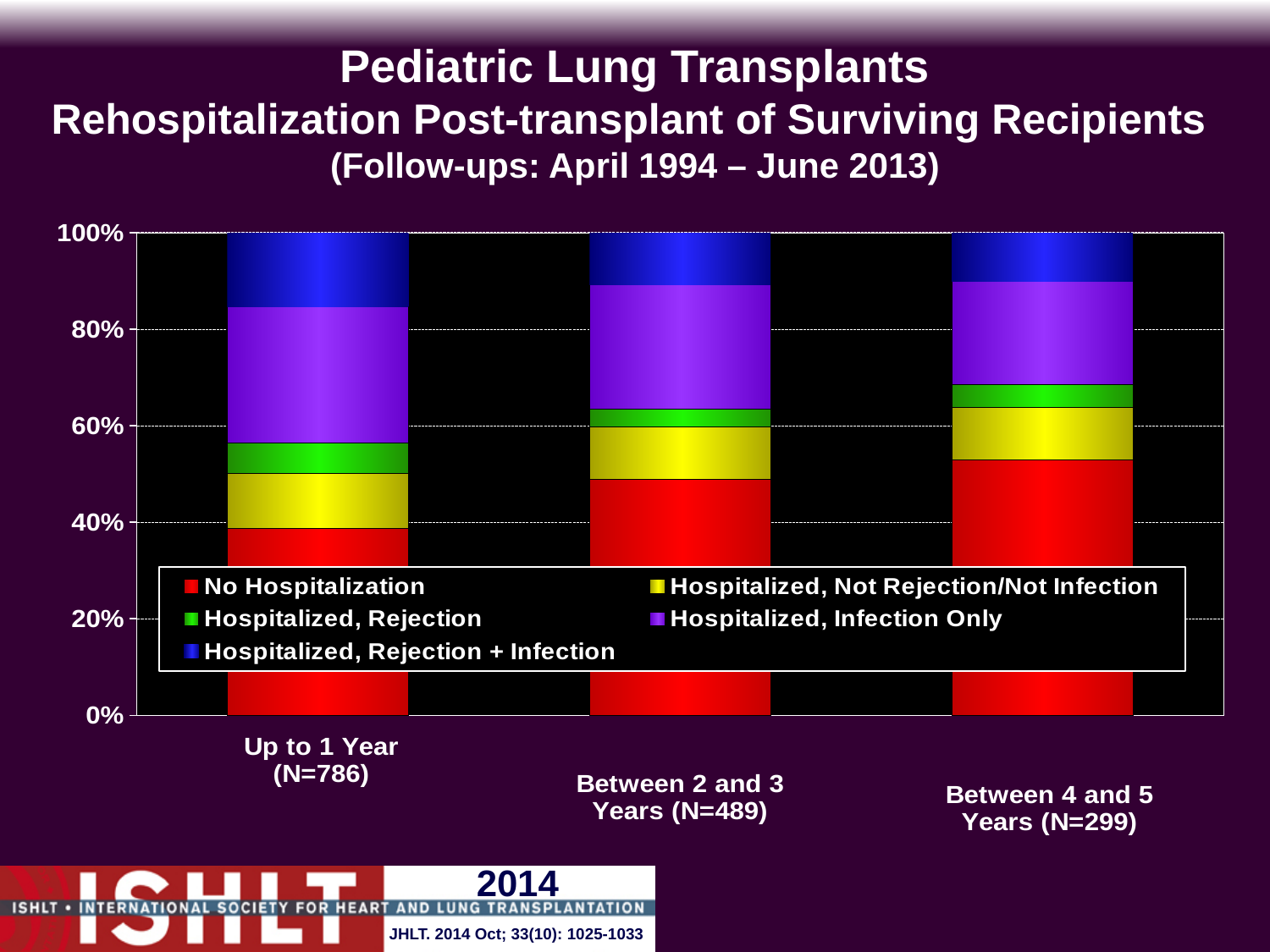
What kind of chart is shown on the slide? Stacked bar chart Which follow-up group has the smallest No Hospitalization share? Up to 1 Year Which colour represents Hospitalized, Infection Only in the legend? Purple How many follow-up time groups are plotted on the x axis? 3 Does the No Hospitalization share rise or fall from Up to 1 Year to Between 4 and 5 Years? rises Which follow-up group has the largest No Hospitalization share? Between 4 and 5 Years Is the No Hospitalization share for Between 2 and 3 Years greater or less than 60%? less How many series does the legend list? 5 What is the N shown for the Up to 1 Year group? 786 Is the No Hospitalization share for Up to 1 Year greater or less than 60%? less Is the No Hospitalization share for Between 4 and 5 Years greater or less than 40%? greater Is the Hospitalized, Rejection segment larger for Up to 1 Year or for Between 2 and 3 Years? Up to 1 Year